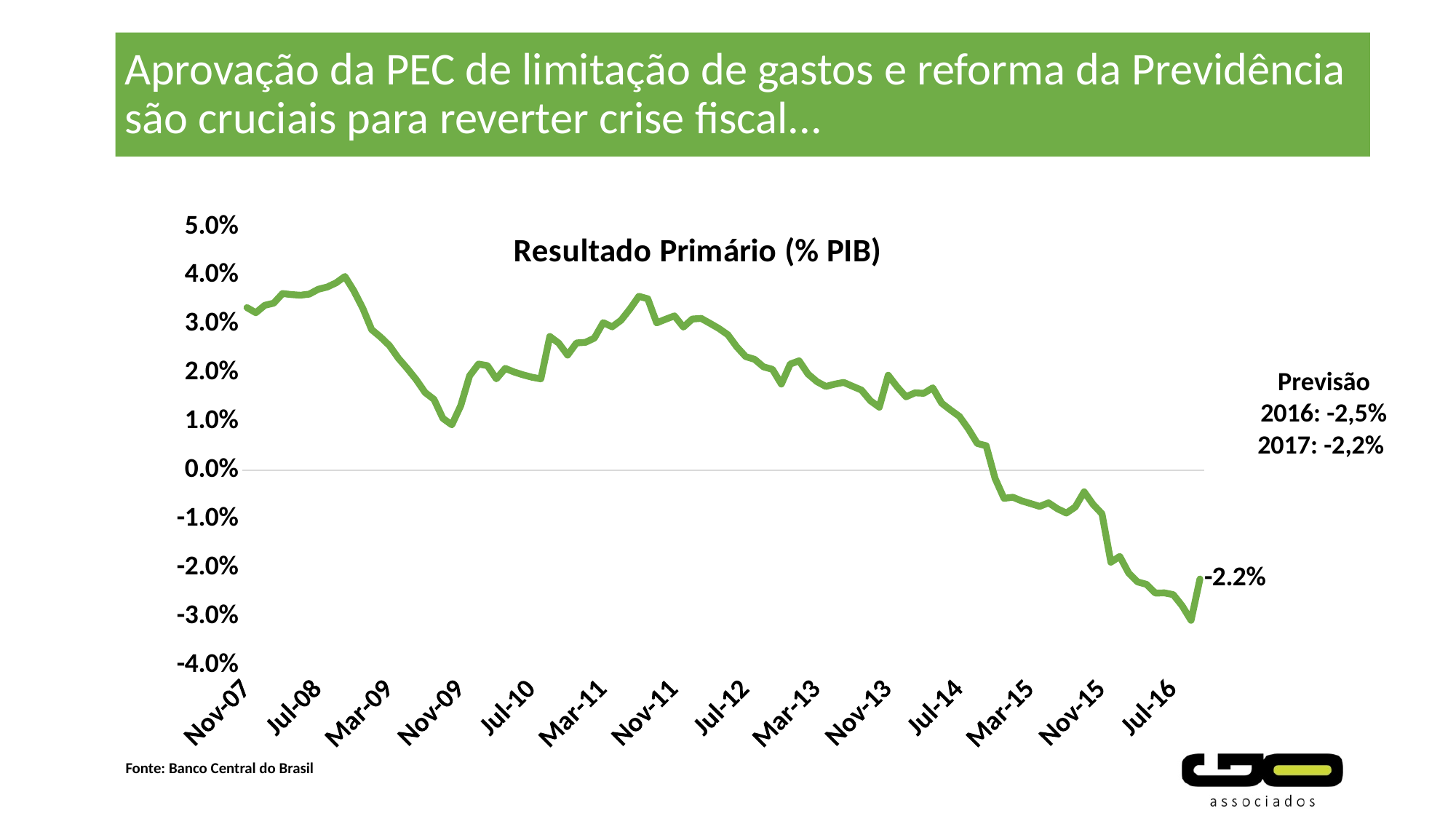
Is the value at Nov-07 greater or less than 2.0%? greater Overall, do the values rise or fall from Nov-07 to Jul-16? fall What kind of chart is shown on the slide? line chart What value is printed as the data label at the end of the line? -2.2% Is the value at Mar-15 greater or less than 0.0%? less Is the value at Jul-16 greater or less than -2.0%? less Which is larger, the value at Nov-11 or the value at Nov-15? Nov-11 How many date labels are shown on the x axis? 14 What is the title of the chart? Resultado Primário (% PIB) What is the highest value shown on the y axis? 5.0%